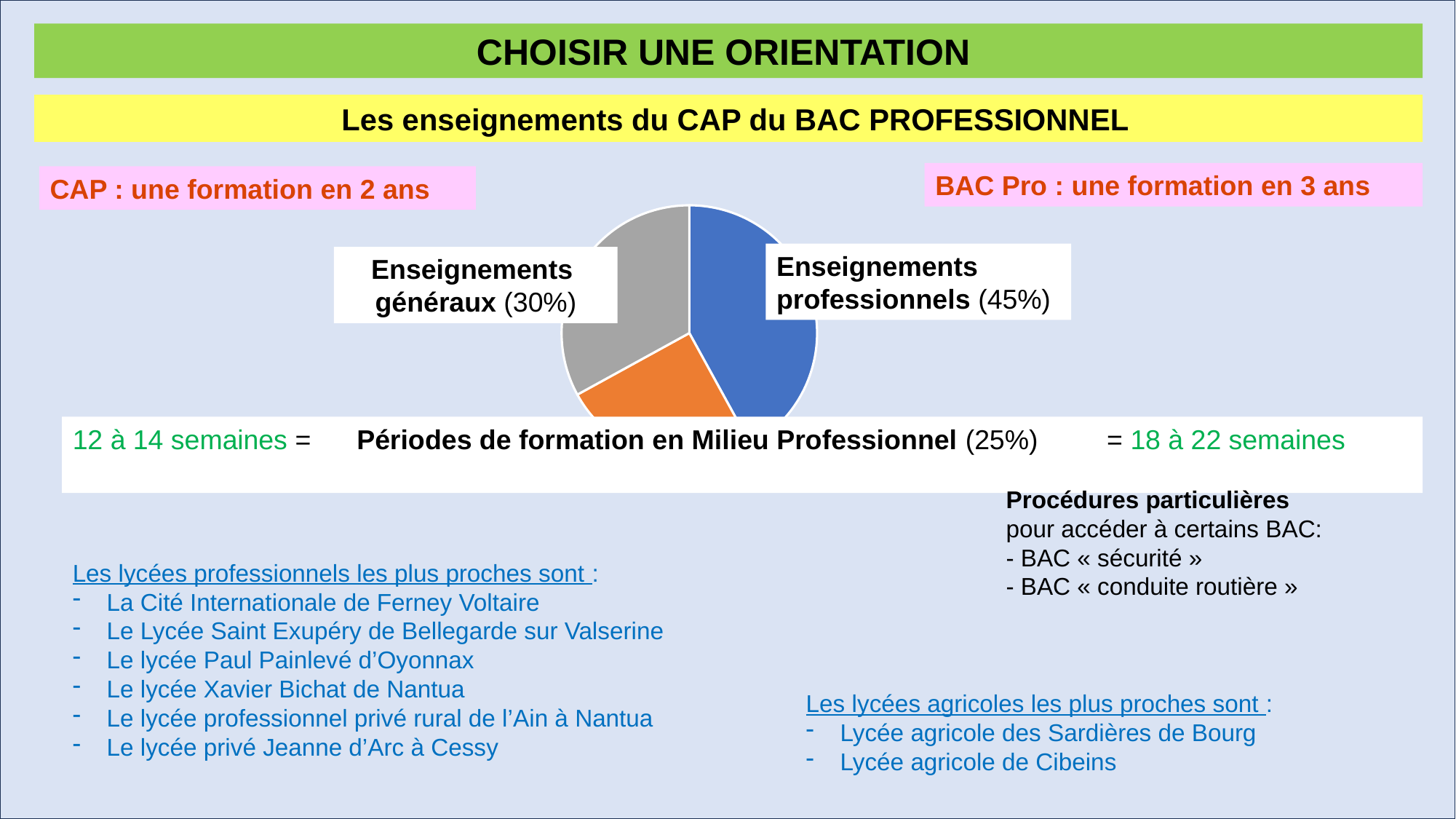
Which slice of the pie chart is the largest? Enseignements professionnels What colour is the Périodes de formation en Milieu Professionnel slice of the pie chart? orange How many slices does the pie chart have? 3 Which is larger, Enseignements généraux or Périodes de formation en Milieu Professionnel? Enseignements généraux Which slice of the pie chart is the smallest? Périodes de formation en Milieu Professionnel What share of the pie is Enseignements généraux? 30% What is the difference in percentage points between Enseignements professionnels and Enseignements généraux? 15 What share of the pie is Enseignements professionnels? 45% What colour is the Enseignements professionnels slice of the pie chart? blue What share of the pie is Périodes de formation en Milieu Professionnel? 25% What kind of chart is shown on the slide? pie chart What is the difference in percentage points between Enseignements généraux and Périodes de formation en Milieu Professionnel? 5